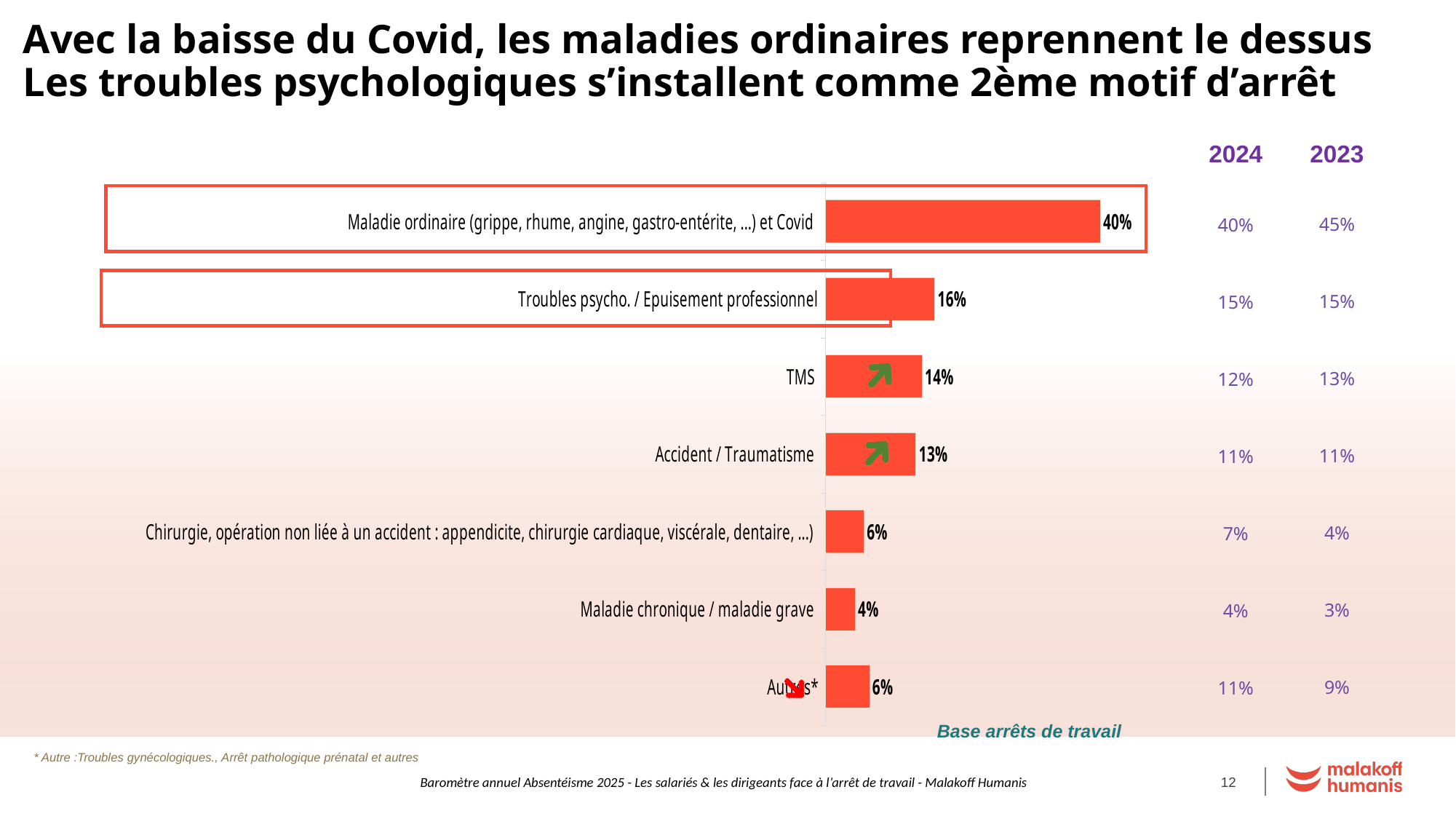
Which category has the lowest value in the chart? Maladie chronique / maladie grave What is the value for "Maladie chronique / maladie grave"? 4% Which category has the highest value in the chart? Maladie ordinaire (grippe, rhume, angine, gastro-entérite, ...) et Covid What is the value for "TMS"? 14% What is the value for "Accident / Traumatisme"? 13% How many categories are shown in the bar chart? 7 Which is larger, the value for "TMS" or the value for "Accident / Traumatisme"? TMS What is the difference between the values for "Maladie ordinaire ... et Covid" and "Troubles psycho. / Epuisement professionnel"? 24% What is the difference between the values for "Chirurgie, opération non liée à un accident" and "Maladie chronique / maladie grave"? 2% What is the value for "Troubles psycho. / Epuisement professionnel"? 16% What is the value for "Maladie ordinaire (grippe, rhume, angine, gastro-entérite, ...) et Covid"? 40% What kind of chart is shown on the slide? Bar chart